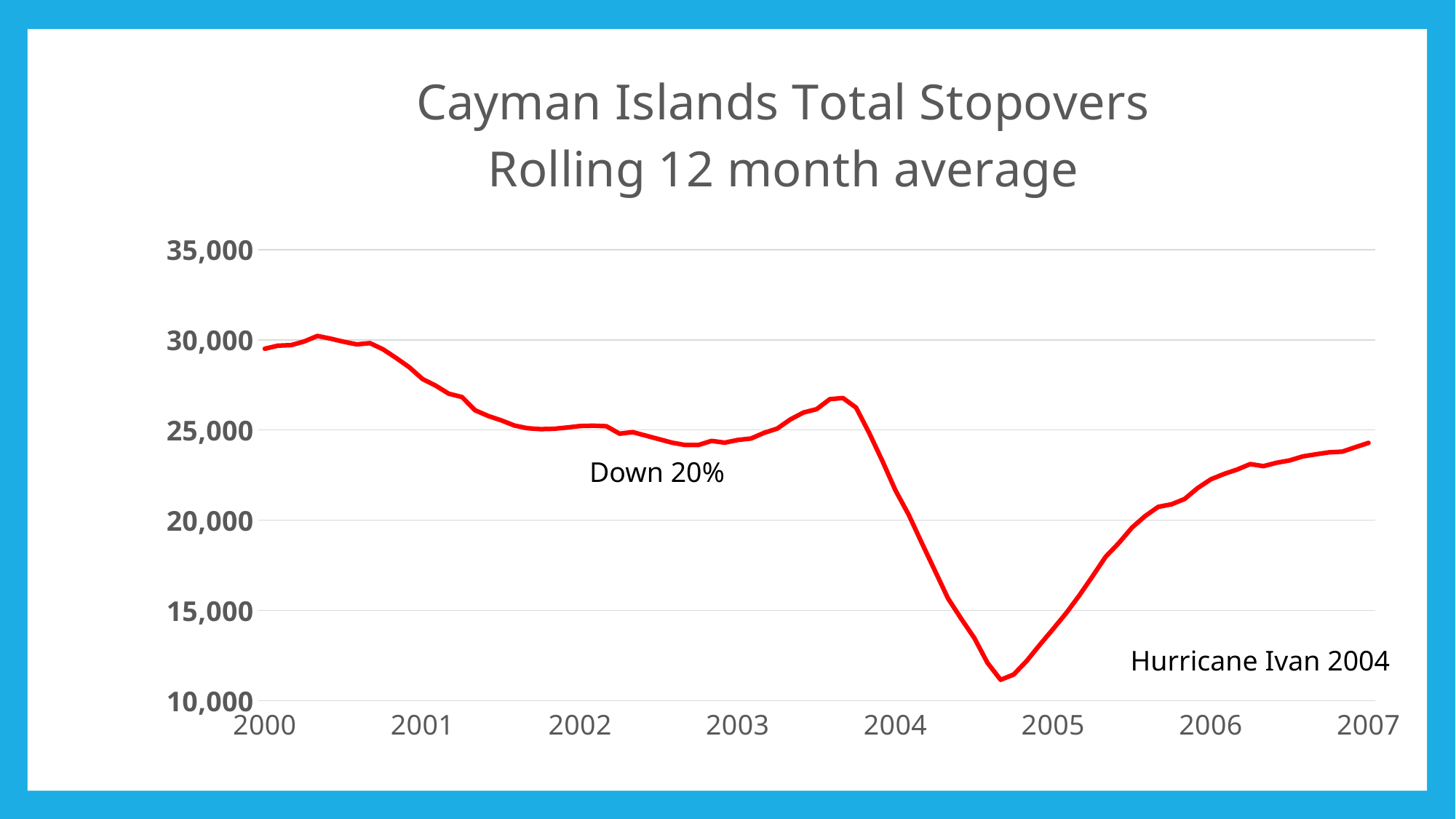
What is the title of the chart? Cayman Islands Total Stopovers Rolling 12 month average What kind of chart is shown on the slide? line chart Does the line rise or fall between 2005 and 2007? rise Is the value at 2007 greater or less than 20,000? greater Which is larger, the value at the start of 2003 or the value at the start of 2005? 2003 Is the lowest point of the line, in late 2004, greater or less than 15,000? less Does the line rise or fall between 2000 and 2002? fall In which year does the line reach its lowest point? 2004 What event is annotated on the chart near the sharp drop? Hurricane Ivan 2004 Is the value at the start of 2000 greater or less than 25,000? greater